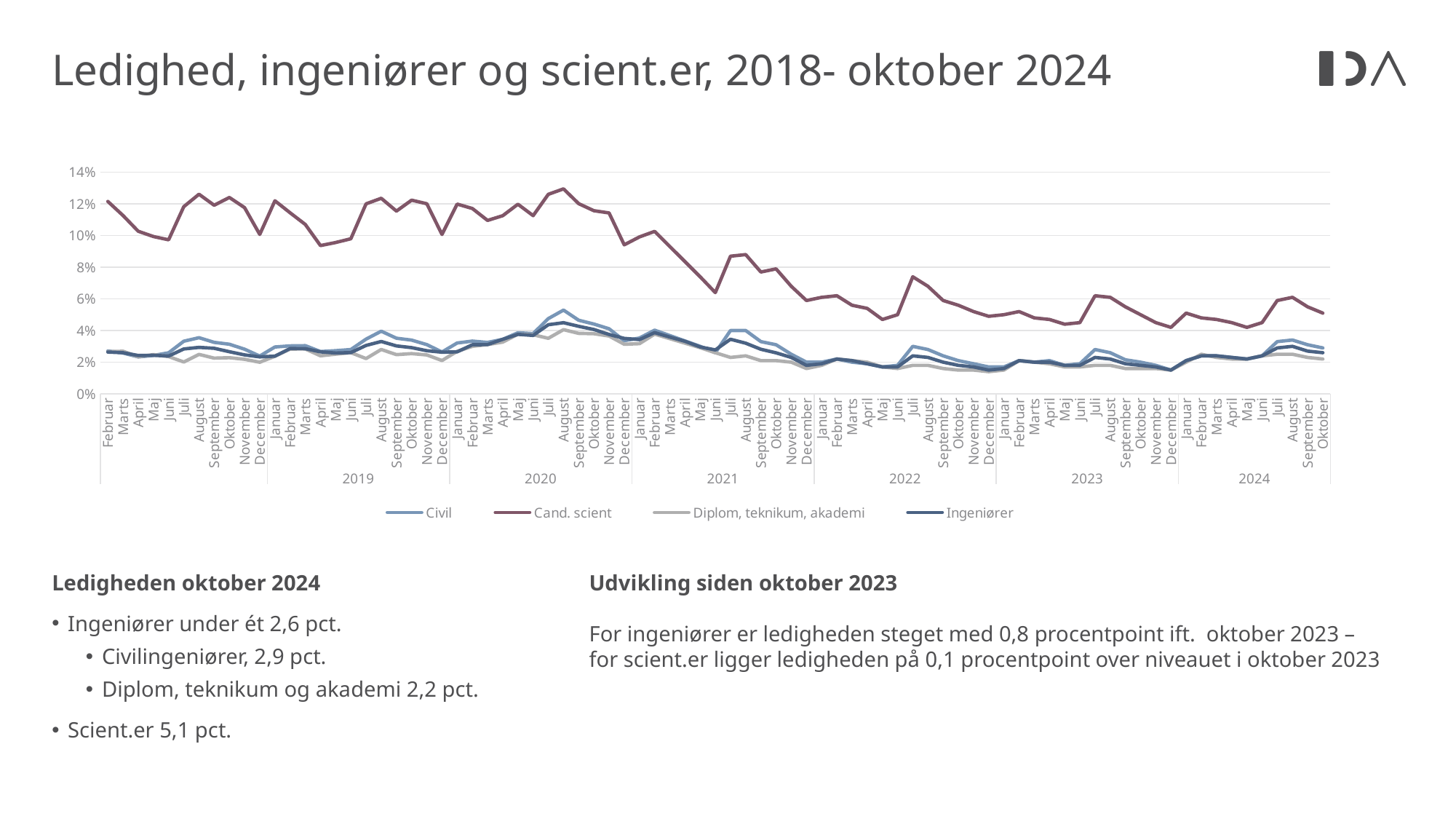
In October 2024, which is larger: the value for Cand. scient or the value for Civil? Cand. scient According to the slide, what is the unemployment rate for Civilingeniører in October 2024? 2,9 pct. According to the slide, what is the unemployment rate for Scient.er in October 2024? 5,1 pct. Is the value for Cand. scient in October 2024 greater or less than 4%? greater Is the value for Civil in August 2020 greater or less than 4%? greater Does the Cand. scient series overall rise or fall from 2018 to 2024? fall Is the value for Cand. scient in August 2020 greater or less than 12%? greater What kind of chart is shown on the slide? line chart Which series has the highest unemployment rate throughout the whole period shown? Cand. scient What is the title of the chart on the slide? Ledighed, ingeniører og scient.er, 2018- oktober 2024 How many series does the chart's legend list? 4